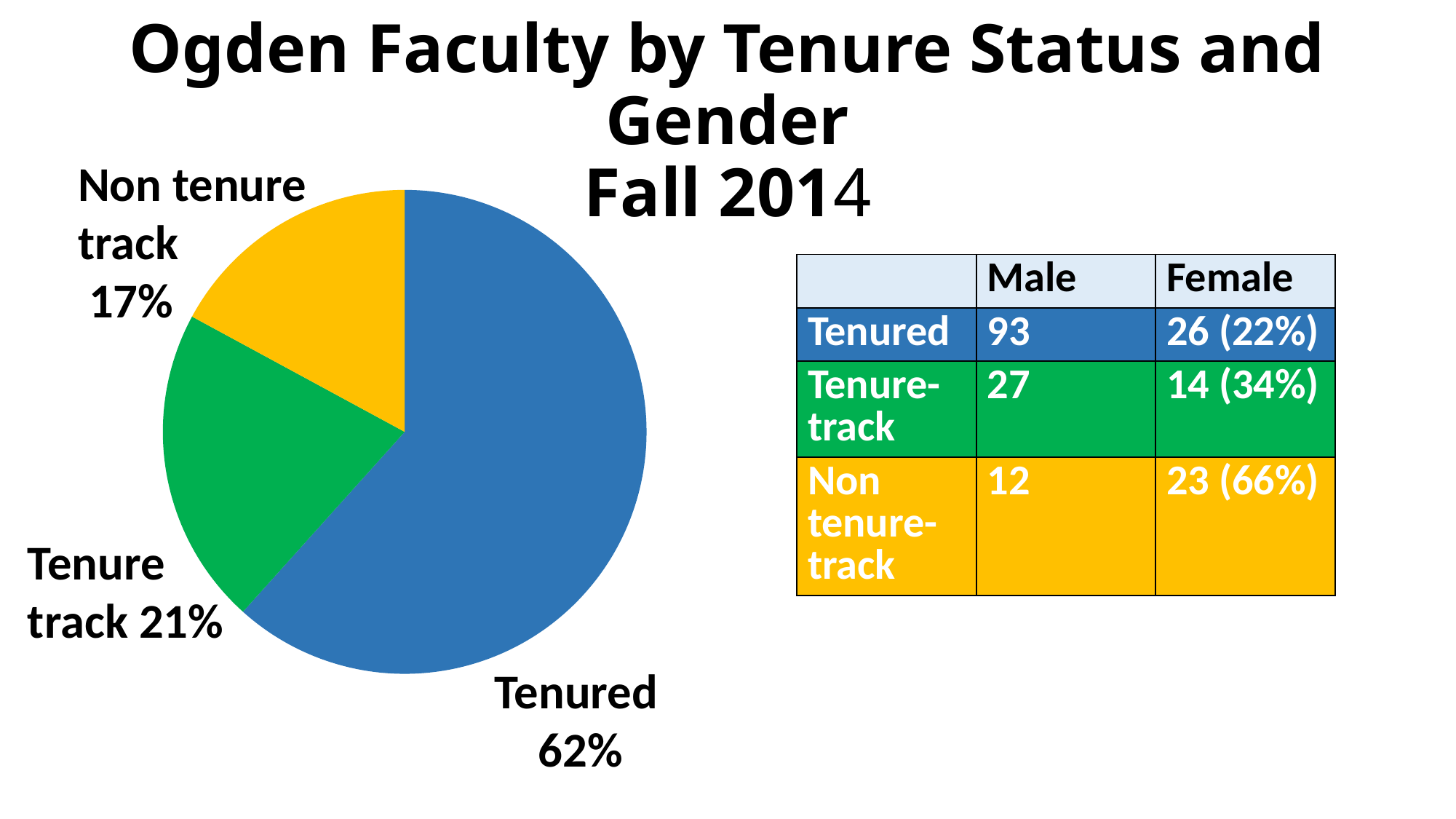
Is the Tenured slice greater or less than 50% of the pie? greater What share of the pie chart is Tenure track? 21% What share of the pie chart is Tenured? 62% What is the difference in percentage points between the Tenured slice and the Tenure track slice? 41 Which slice of the pie chart is the smallest? Non tenure track What colour is the Tenured slice of the pie chart? Blue Which slice is larger, Tenure track or Non tenure track? Tenure track What kind of chart is shown on the slide? Pie chart Which slice of the pie chart is the largest? Tenured What share of the pie chart is Non tenure track? 17% What is the title of the slide containing the pie chart? Ogden Faculty by Tenure Status and Gender Fall 2014 How many slices does the pie chart have? 3